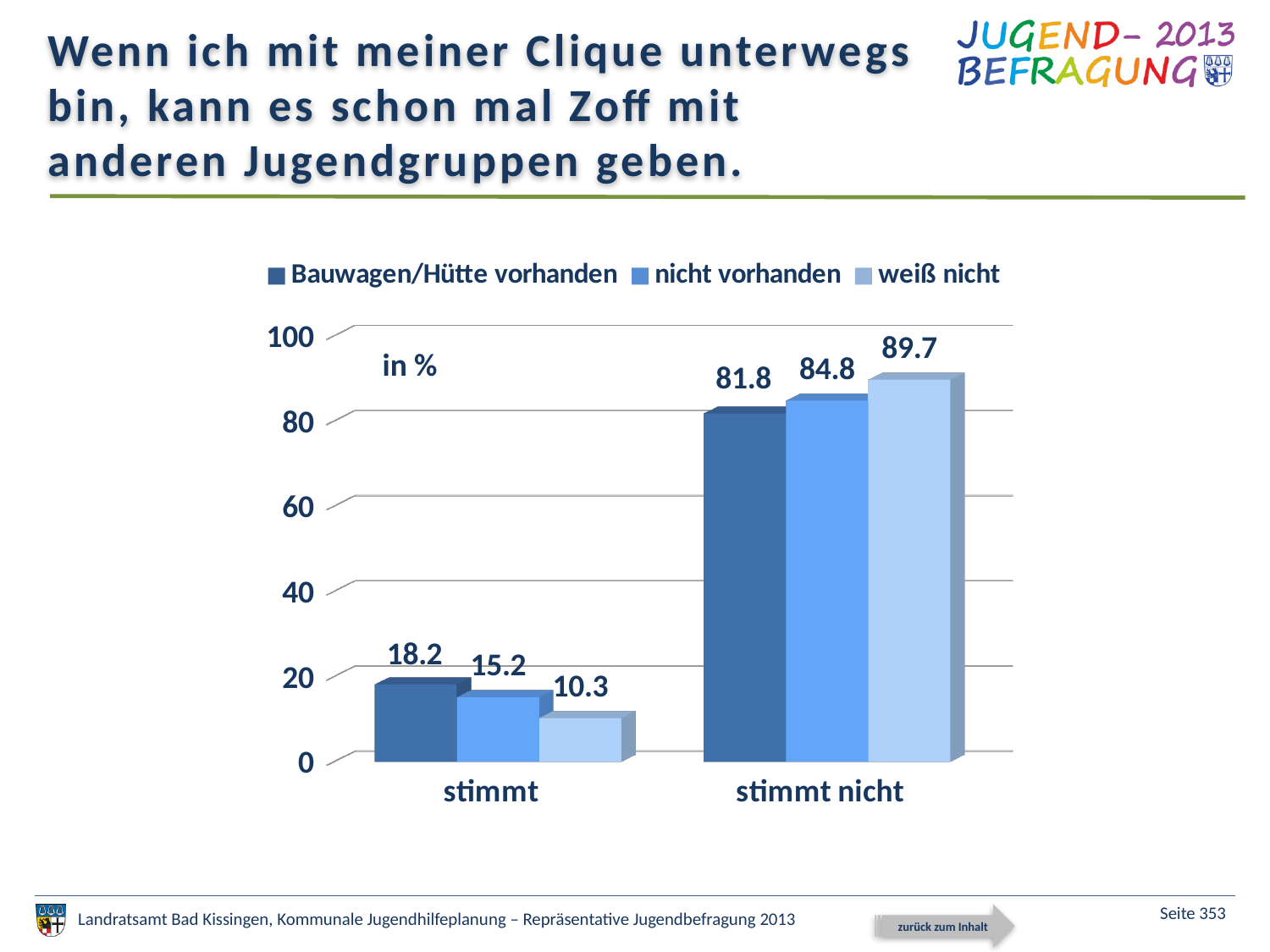
Which series has the lowest value in the "stimmt" category? weiß nicht What is the value for "weiß nicht" in the "stimmt nicht" category? 89.7 Which series has the highest value in the "stimmt nicht" category? weiß nicht What is the difference between the "weiß nicht" and "Bauwagen/Hütte vorhanden" values in the "stimmt nicht" category? 7.9 Is the value for "nicht vorhanden" in the "stimmt nicht" category greater or less than 80? greater What is the value for "Bauwagen/Hütte vorhanden" in the "stimmt" category? 18.2 How many series does the legend list? 3 What is the value for "nicht vorhanden" in the "stimmt" category? 15.2 How many categories are shown on the x axis? 2 What kind of chart is shown on the slide? bar chart Which is larger: the "nicht vorhanden" value for "stimmt" or the "weiß nicht" value for "stimmt"? nicht vorhanden What unit is indicated inside the chart area? in %